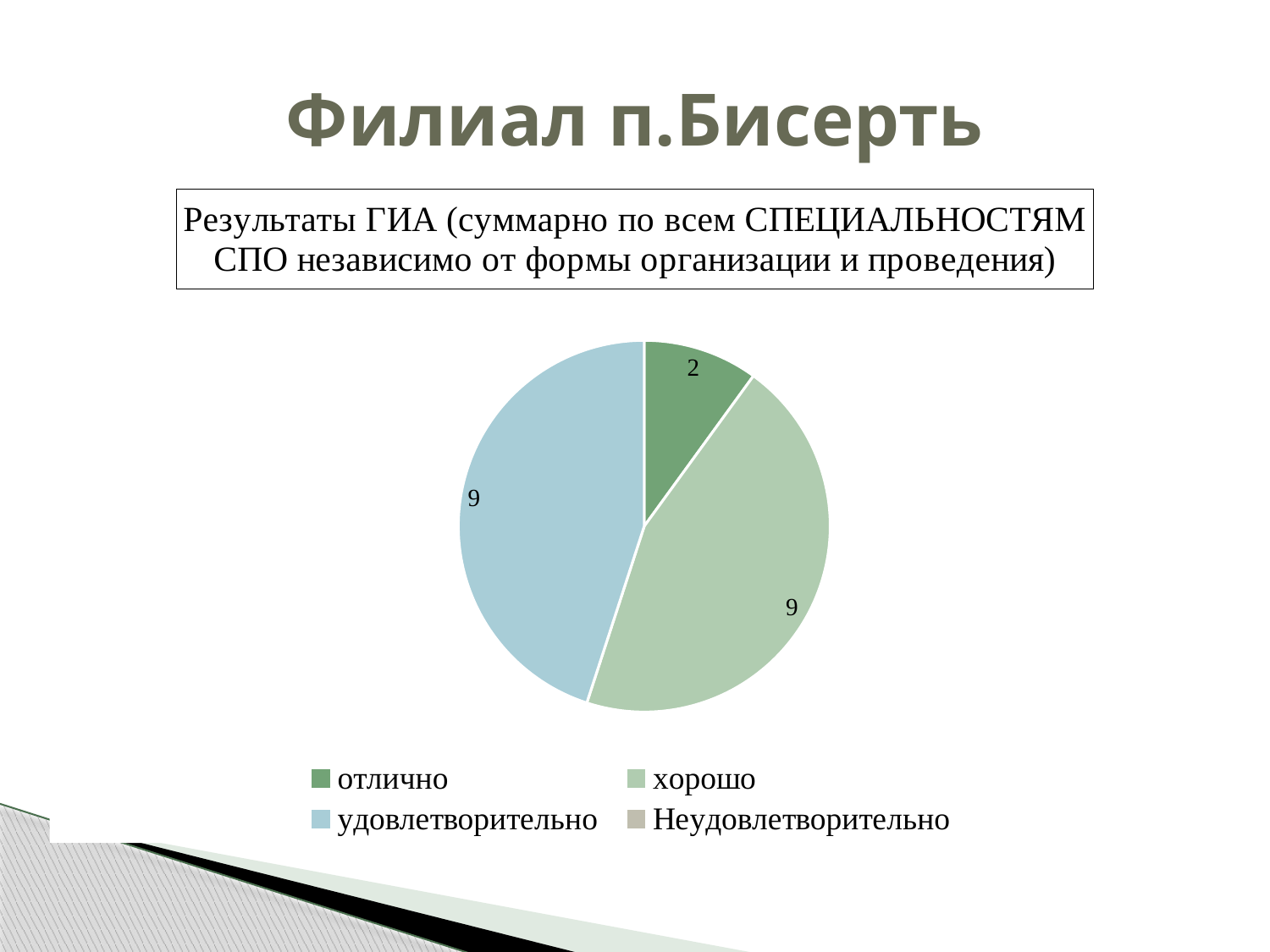
What is the value for the "удовлетворительно" slice? 9 What is the value for the "хорошо" slice? 9 What colour is the "отлично" slice in the pie chart? dark green What type of chart is shown on the slide? pie chart What is the total of all the values shown on the pie chart? 20 How many categories does the legend of the pie chart list? 4 Which is larger, the value for "хорошо" or the value for "отлично"? хорошо What is the difference between the values for "хорошо" and "отлично"? 7 What share of the pie does the "отлично" slice represent? 10% Which category has the smallest slice in the pie chart? отлично What is the value for the "отлично" slice? 2 What share of the pie does the "хорошо" slice represent? 45%